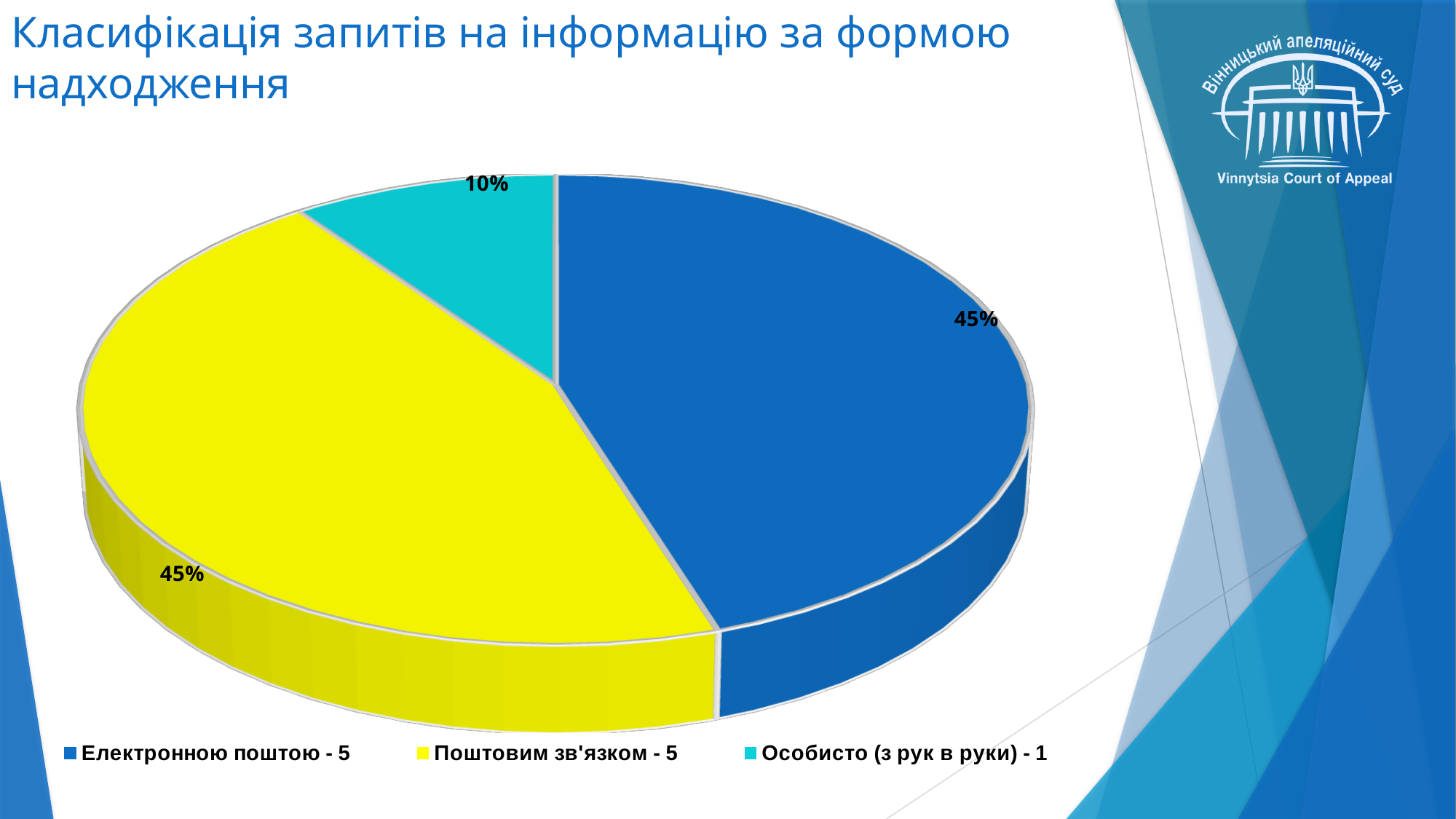
What percentage share does the slice for "Електронною поштою - 5" have? 45% What kind of chart is shown on the slide? pie chart What percentage share does the slice for "Особисто (з рук в руки) - 1" have? 10% How many entries does the legend list? 3 What is the difference in percentage points between the "Електронною поштою - 5" slice and the "Особисто (з рук в руки) - 1" slice? 35 How many slices does the pie chart have? 3 What percentage share does the slice for "Поштовим зв'язком - 5" have? 45% Which slice is larger: "Поштовим зв'язком - 5" or "Особисто (з рук в руки) - 1"? Поштовим зв'язком - 5 Which category has the smallest slice of the pie? Особисто (з рук в руки) - 1 What colour is the slice for "Особисто (з рук в руки) - 1"? cyan What is the combined percentage share of the "Електронною поштою - 5" and "Поштовим зв'язком - 5" slices? 90% What is the title of the chart slide? Класифікація запитів на інформацію за формою надходження